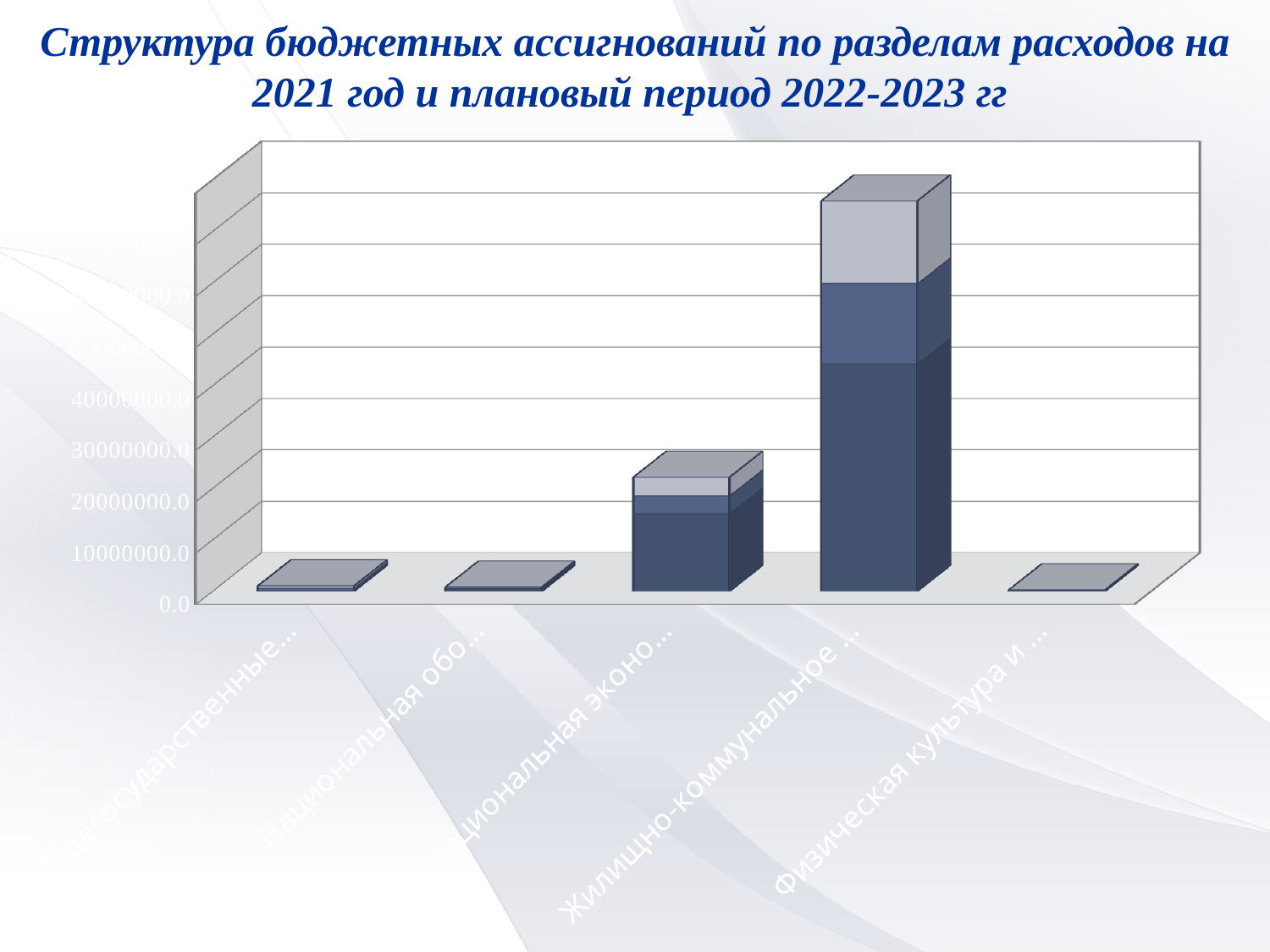
How many stacked segments make up the tallest bar in the chart? 3 What is the title of the slide containing the chart? Структура бюджетных ассигнований по разделам расходов на 2021 год и плановый период 2022-2023 гг Is the total value of the bar for 'Национальная эконо...' greater or less than 10000000.0? greater Is the value of the first bar ('Общегосударственные...') greater or less than 10000000.0? less Is the total value of the bar for 'Национальная эконо...' greater or less than 30000000.0? less Which category has the tallest bar in the chart? Жилищно-коммунальное ... How many categories are shown on the x axis of the chart? 5 What kind of chart is shown on the slide? bar chart Which bar is taller: 'Общегосударственные...' or 'Национальная эконо...'? Национальная эконо... Which bar is taller: 'Национальная эконо...' or 'Жилищно-коммунальное ...'? Жилищно-коммунальное ...